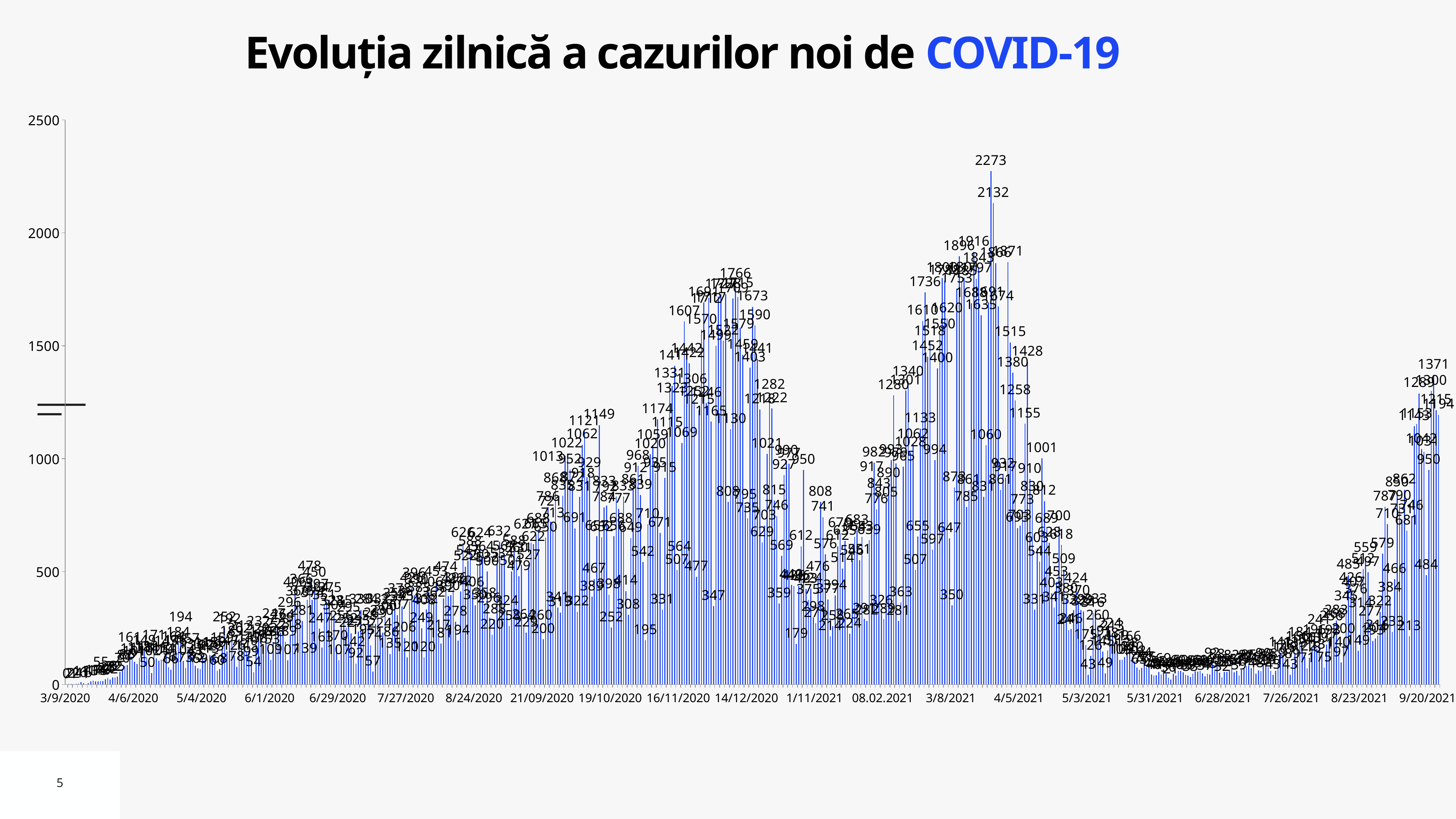
What is the highest daily value labelled on the chart? 2273 What is the difference between the two highest labelled values, 2273 and 2132? 141 Which is larger: the peak of the wave around 4/5/2021 or the peak of the wave around 14/12/2020? the peak around 4/5/2021 Do the daily values rise or fall between 7/26/2021 and 9/20/2021? rise What is the title of the chart? Evoluția zilnică a cazurilor noi de COVID-19 What is the highest value labelled in the wave between 16/11/2020 and 14/12/2020? 1766 Is the highest value on the chart greater or less than 2500? less What is the second-highest daily value labelled on the chart, next to the 2273 peak? 2132 What is the highest value labelled near the right end of the chart, around 9/20/2021? 1371 What kind of chart is shown on the slide? bar chart Is the highest value on the chart greater or less than 2000? greater What colour are the bars in the chart? blue